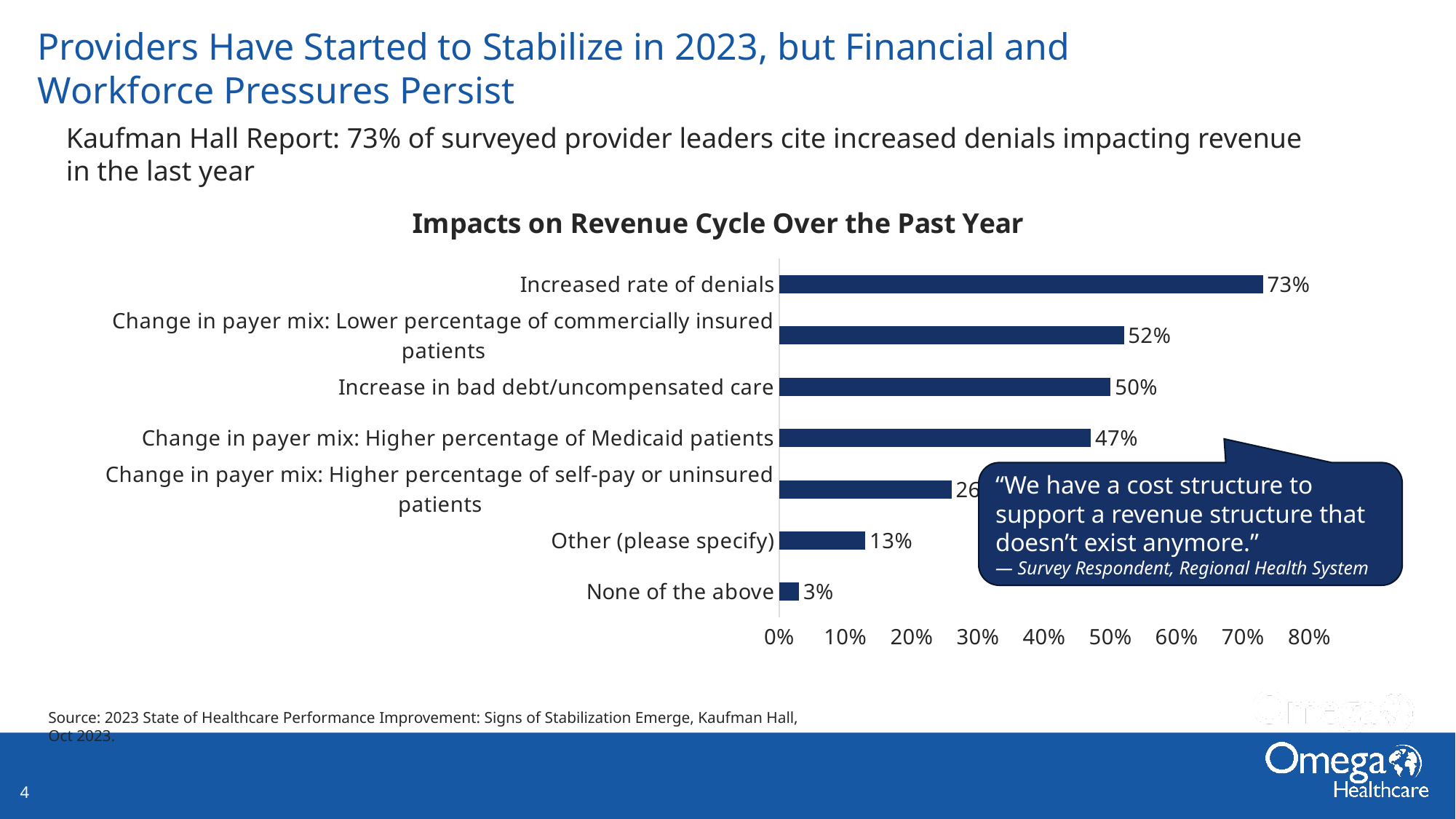
How many categories are shown in the chart? 7 What is the value for "Change in payer mix: Higher percentage of Medicaid patients"? 47% Is the value for "Change in payer mix: Higher percentage of self-pay or uninsured patients" greater or less than 30%? less What is the title of the chart? Impacts on Revenue Cycle Over the Past Year What is the value for "Other (please specify)"? 13% What percentage of surveyed provider leaders cited an increased rate of denials? 73% What is the value for "Increase in bad debt/uncompensated care"? 50% Which is larger: the value for "Increase in bad debt/uncompensated care" or the value for "Change in payer mix: Higher percentage of Medicaid patients"? Increase in bad debt/uncompensated care What is the difference between the value for "Increased rate of denials" and the value for "Change in payer mix: Lower percentage of commercially insured patients"? 21% Which category has the highest value in the chart? Increased rate of denials Which category has the lowest value in the chart? None of the above What kind of chart is shown on the slide? Bar chart